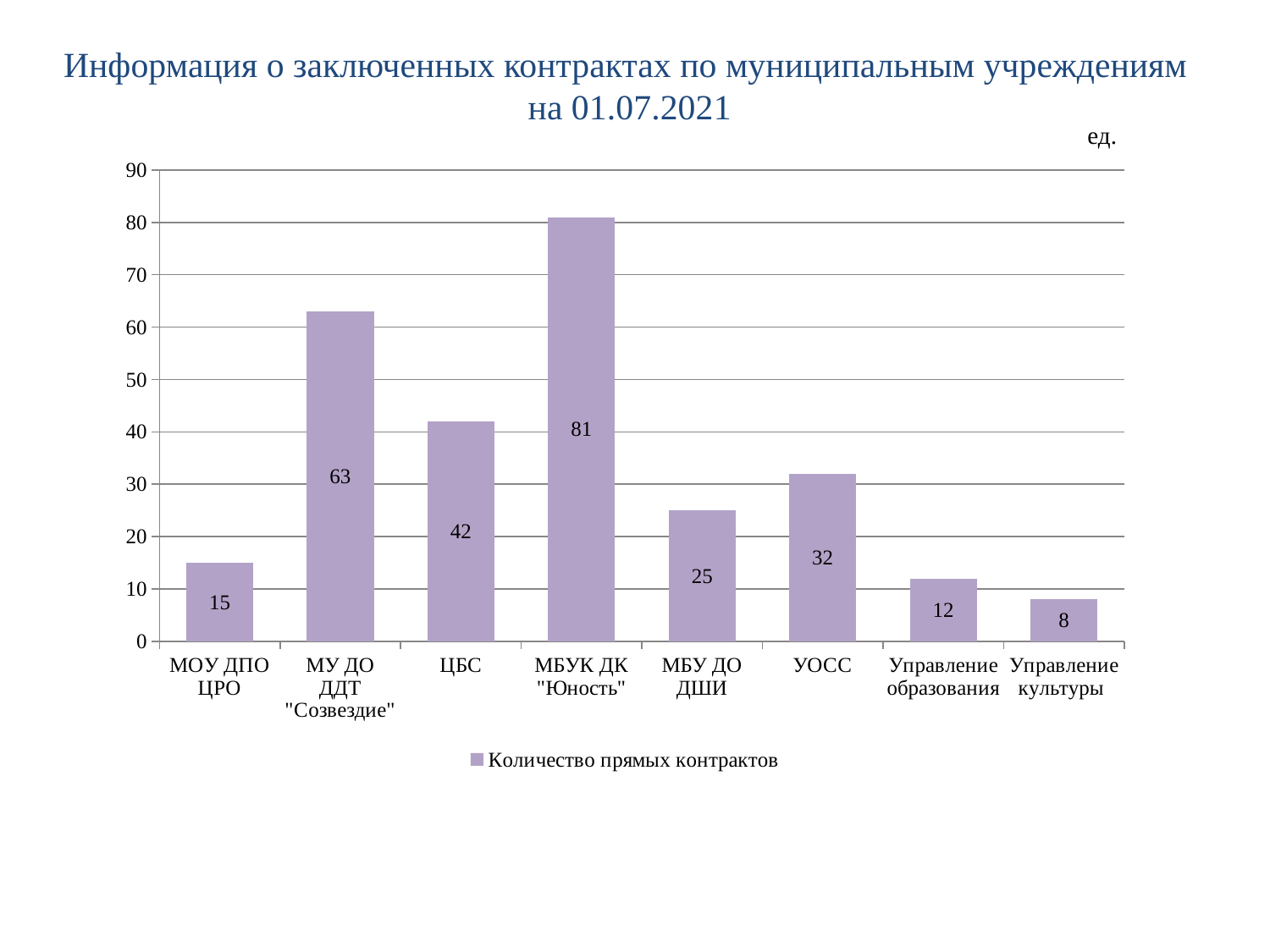
How many categories are shown on the x axis? 8 Is the value for МУ ДО ДДТ "Созвездие" greater or less than 60? greater Which is larger, the value for УОСС or the value for МОУ ДПО ЦРО? УОСС What is the value for ЦБС? 42 What is the legend entry for the series shown? Количество прямых контрактов What is the difference between the values for МУ ДО ДДТ "Созвездие" and МБУ ДО ДШИ? 38 Which category has the highest value? МБУК ДК "Юность" How many series does the legend list? 1 What is the value for МБУК ДК "Юность"? 81 Which category has the lowest value? Управление культуры What is the value for Управление образования? 12 What kind of chart is shown on the slide? bar chart